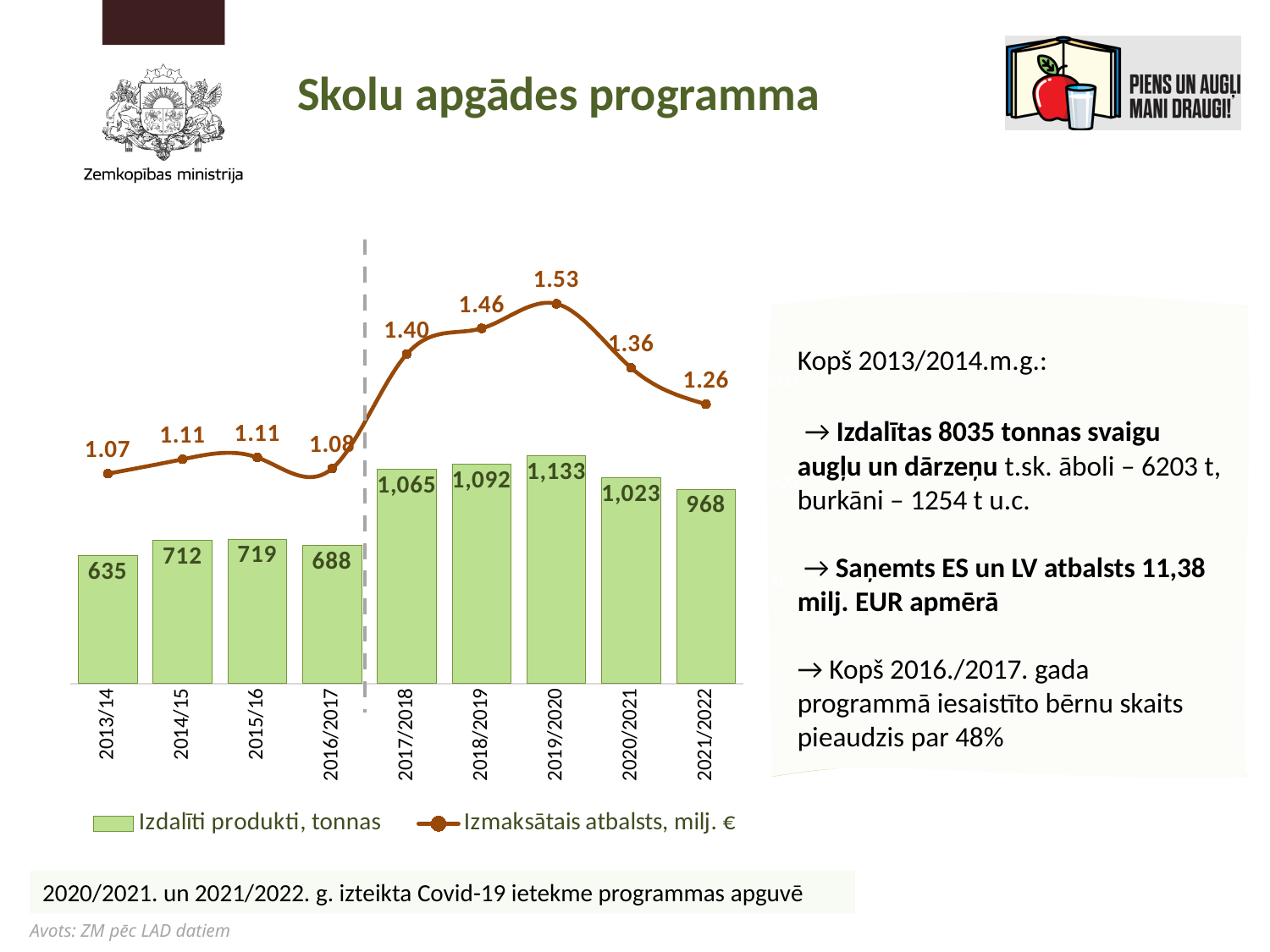
What is the difference in Izmaksātais atbalsts, milj. € between 2019/2020 and 2013/14? 0.46 What is the value of Izdalīti produkti, tonnas for 2013/14? 635 Which school year has the lowest value for Izdalīti produkti, tonnas? 2013/14 Does Izmaksātais atbalsts, milj. € rise or fall from 2019/2020 to 2021/2022? Fall What is the value of Izmaksātais atbalsts, milj. € for 2017/2018? 1.40 What kinds of chart are combined on the slide? Bar chart and line chart Which school year has the highest value for Izmaksātais atbalsts, milj. €? 2019/2020 How many school years are shown on the x axis of the chart? 9 How many series does the chart legend list? 2 Which is larger, Izdalīti produkti, tonnas for 2014/15 or for 2016/2017? 2014/15 What is the difference in Izdalīti produkti, tonnas between 2019/2020 and 2021/2022? 165 What is the value of Izdalīti produkti, tonnas for 2019/2020? 1,133